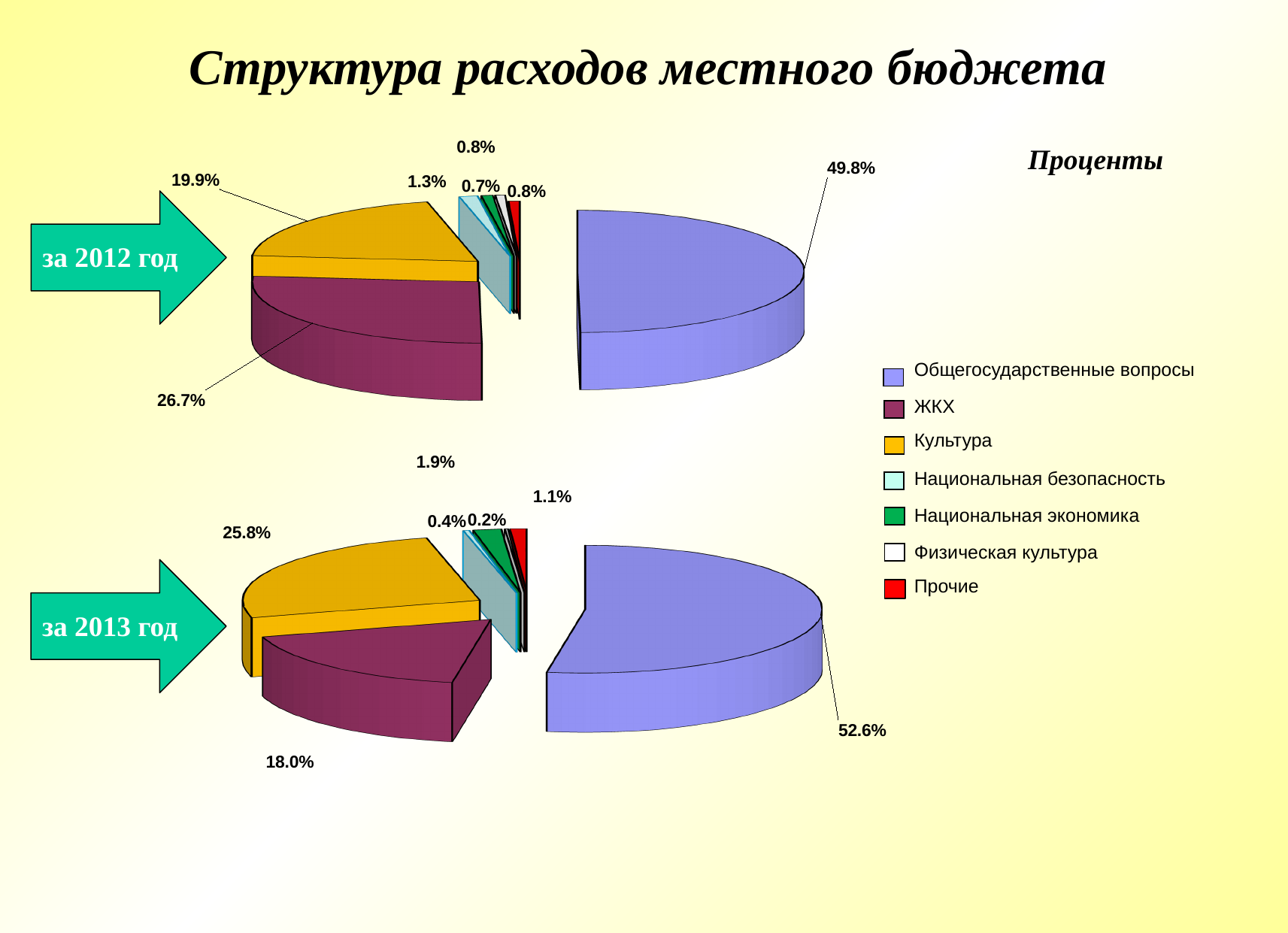
In the chart for 2013 (за 2013 год), what share is ЖКХ? 18.0% How many categories does the legend list? 7 In the chart for 2012 (за 2012 год), which is larger, ЖКХ or Культура? ЖКХ In the chart for 2012 (за 2012 год), what share is ЖКХ? 26.7% Which colour represents Культура in the legend? Yellow In the chart for 2013 (за 2013 год), what share is Культура? 25.8% In the chart for 2012 (за 2012 год), which category has the largest share? Общегосударственные вопросы What type of charts are shown on the slide? Pie charts In the chart for 2012 (за 2012 год), what share is Общегосударственные вопросы? 49.8% In the chart for 2013 (за 2013 год), which is larger, ЖКХ or Культура? Культура In the chart for 2013 (за 2013 год), what share is Общегосударственные вопросы? 52.6% By how many percentage points did the share of Общегосударственные вопросы change from the 2012 chart to the 2013 chart? 2.8